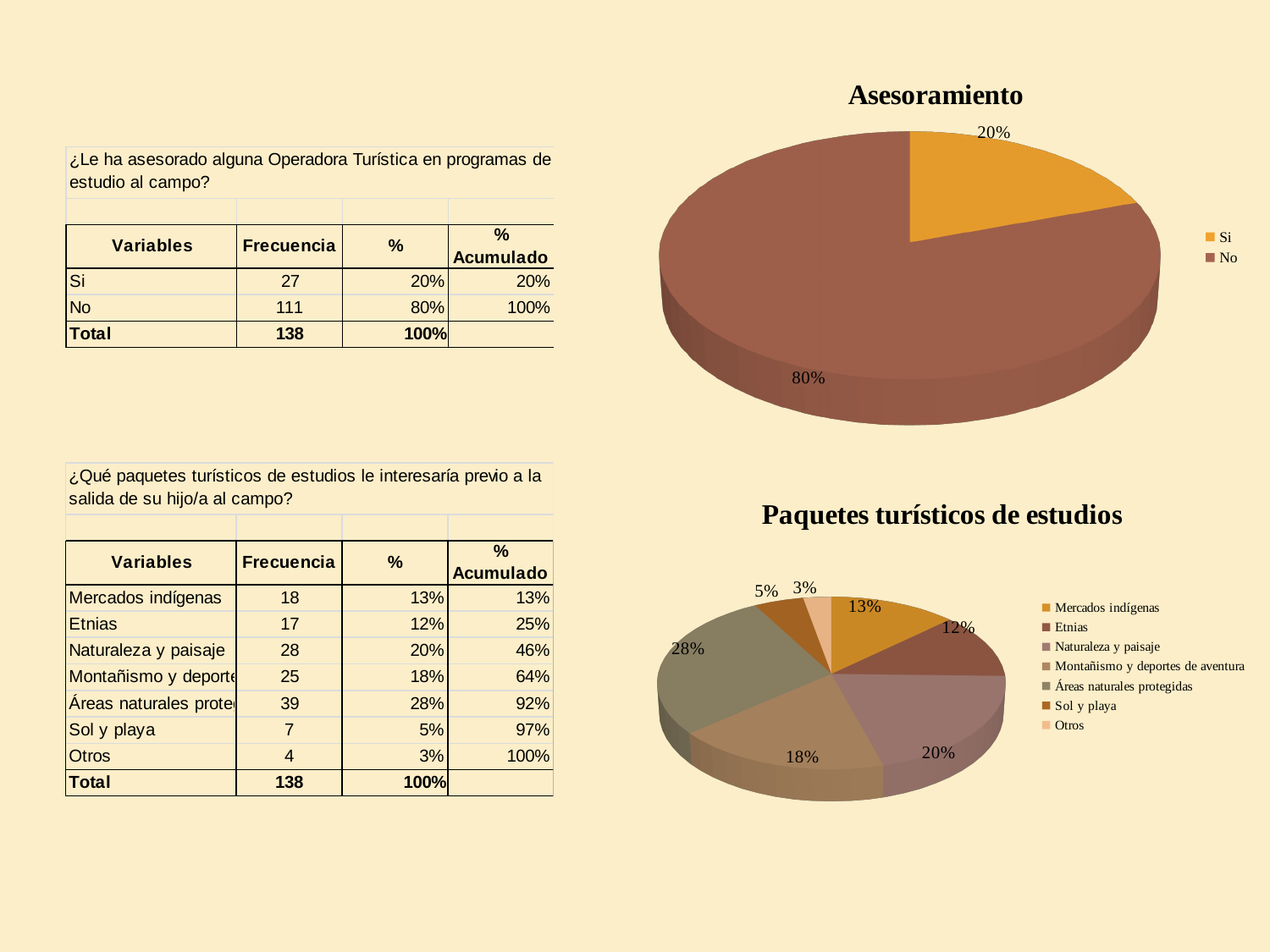
In the 'Paquetes turísticos de estudios' chart, which is larger: 'Mercados indígenas' or 'Montañismo y deportes de aventura'? Montañismo y deportes de aventura In the 'Paquetes turísticos de estudios' chart, what share of the pie is 'Sol y playa'? 5% What is the title of the pie chart at the bottom right of the slide? Paquetes turísticos de estudios In the 'Paquetes turísticos de estudios' chart, what is the difference between the shares of 'Áreas naturales protegidas' and 'Etnias'? 16% In the 'Paquetes turísticos de estudios' chart, what share of the pie is 'Naturaleza y paisaje'? 20% How many series does the legend of the 'Asesoramiento' chart list? 2 In the 'Asesoramiento' chart, what share of the pie is 'No'? 80% In the 'Paquetes turísticos de estudios' chart, which category has the largest slice? Áreas naturales protegidas How many categories does the legend of the 'Paquetes turísticos de estudios' chart list? 7 What kind of chart is the 'Asesoramiento' chart? Pie chart In the 'Paquetes turísticos de estudios' chart, which category has the smallest slice? Otros